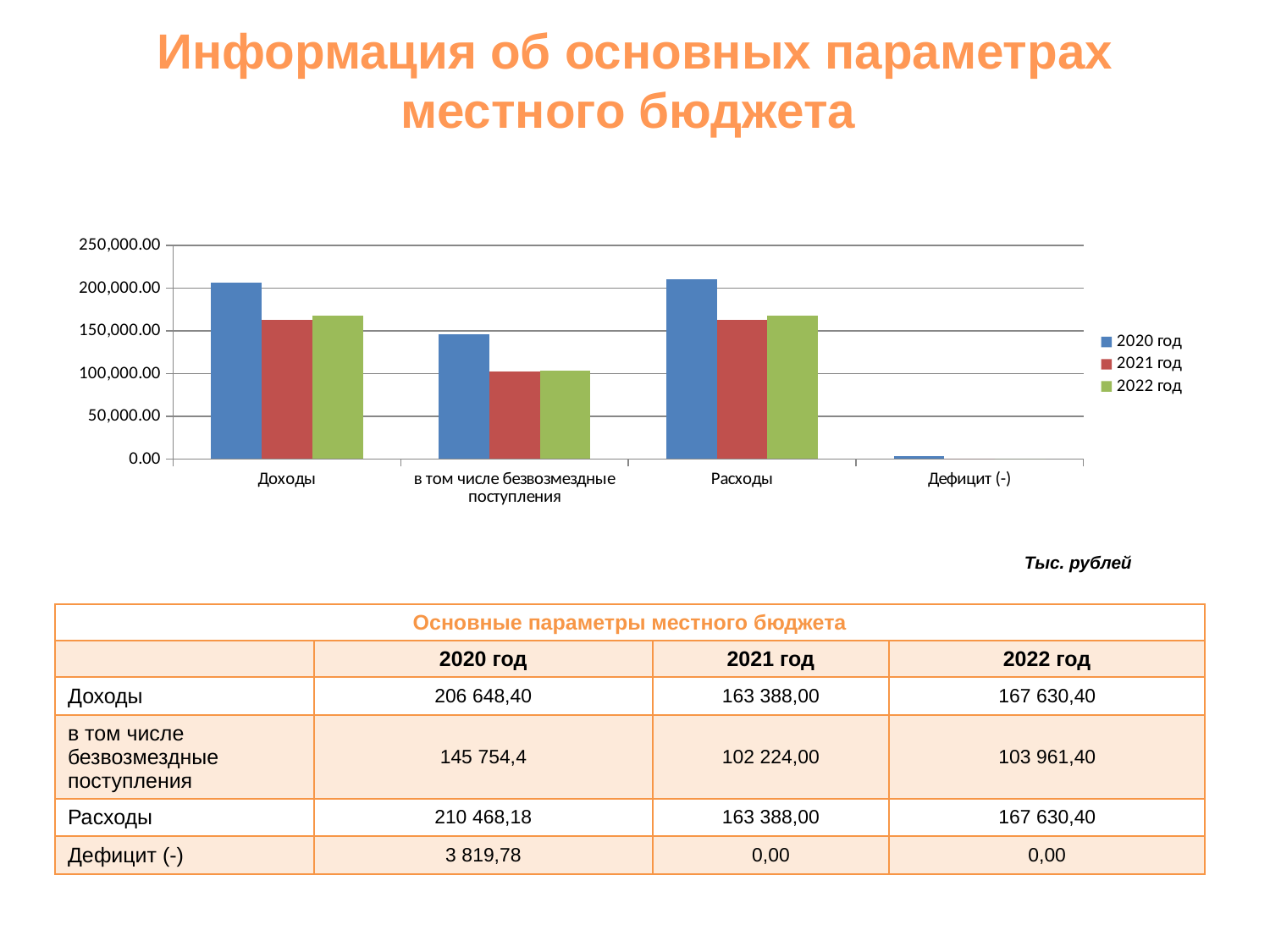
Which year has the highest bar for Доходы? 2020 год Which category has the lowest values in the chart? Дефицит (-) What kind of chart is shown on the slide? bar chart What is the difference between Расходы and Доходы for 2020 год? 3 819,78 Which is larger for Доходы: the 2021 год value or the 2022 год value? 2022 год What is the value of Доходы for 2020 год? 206 648,40 Is the 2020 год bar for Расходы greater or less than 200,000.00? greater How many series does the chart legend list? 3 Is the 2021 год bar for в том числе безвозмездные поступления greater or less than 150,000.00? less What is the value of Расходы for 2022 год? 167 630,40 What is the value of Дефицит (-) for 2020 год? 3 819,78 How many categories are shown on the x axis of the chart? 4